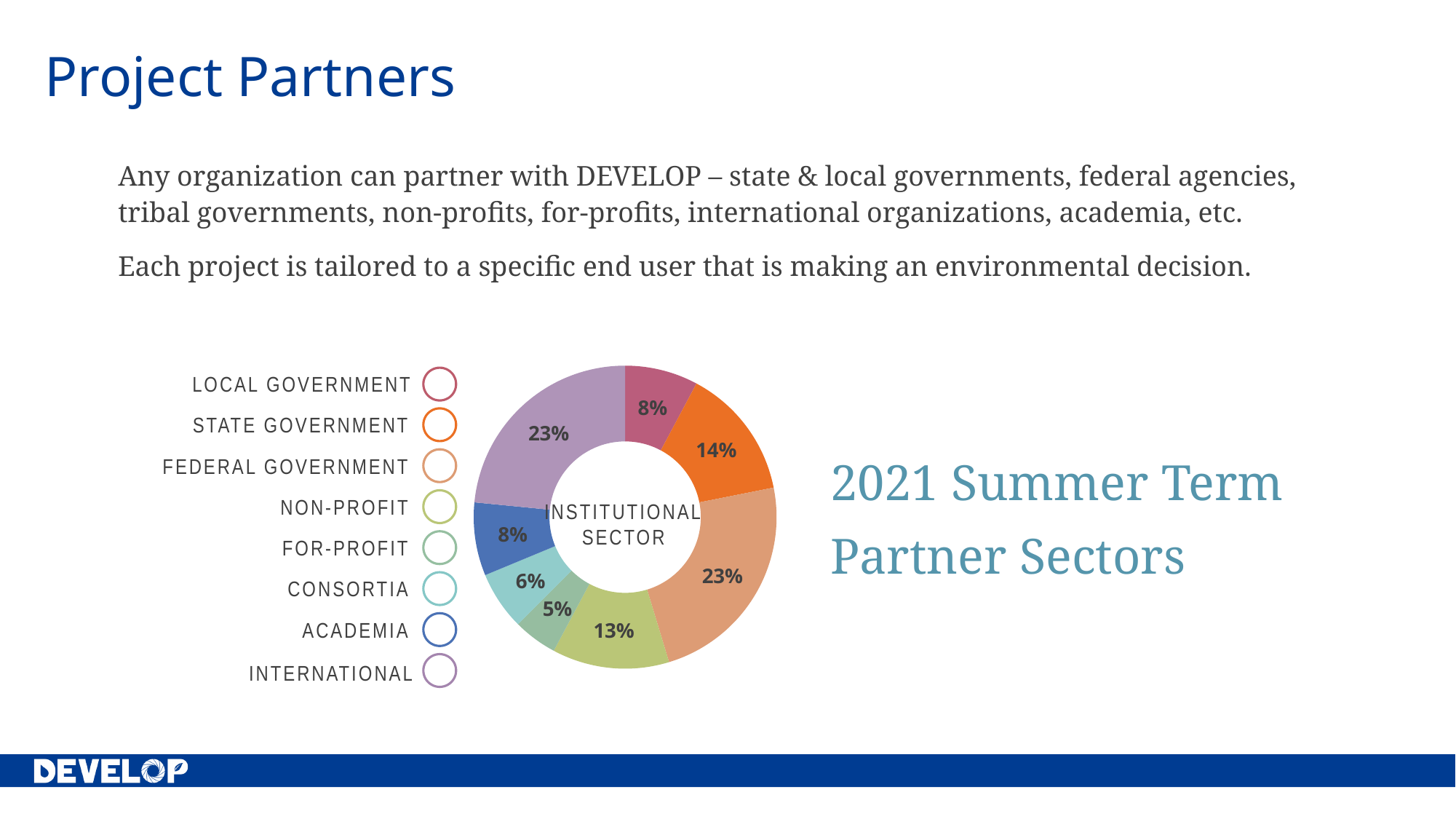
What is the share for Federal Government in the partner sectors chart? 23% Which sector has the smallest share in the partner sectors chart? For-Profit What percentage is shown for International in the partner sectors chart? 23% How many sectors are shown in the partner sectors chart? 8 What text appears in the center of the donut chart? INSTITUTIONAL SECTOR What share does Consortia have in the partner sectors chart? 6% What percentage does State Government account for in the partner sectors chart? 14% What is the difference in percentage points between State Government and Academia in the partner sectors chart? 6 What share of the 2021 Summer Term Partner Sectors chart is Local Government? 8% What percentage of the partner sectors chart is Non-Profit? 13% What type of chart is used to show the 2021 Summer Term Partner Sectors? Donut (pie) chart Which has a larger share in the partner sectors chart, Non-Profit or Consortia? Non-Profit